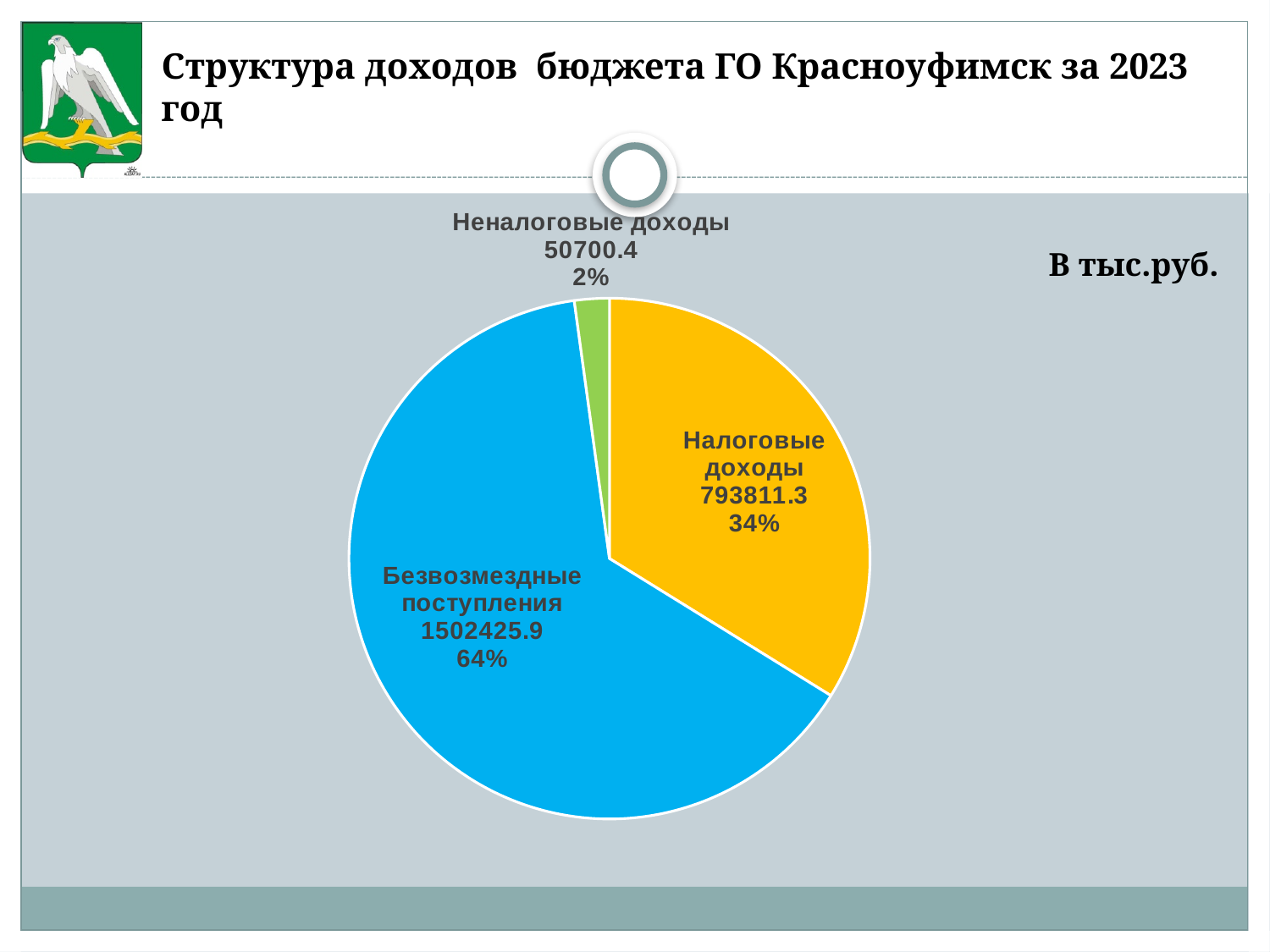
What type of chart is shown on the slide? pie chart Which category has the smallest share of the pie? Неналоговые доходы Which category has the largest share of the pie? Безвозмездные поступления What share of the pie does Налоговые доходы represent? 34% What is the value for Налоговые доходы? 793811.3 What share of the pie does Неналоговые доходы represent? 2% How many slices does the pie chart have? 3 What is the value for Безвозмездные поступления? 1502425.9 In what units are the values on the chart given, according to the slide? тыс.руб. What is the value for Неналоговые доходы? 50700.4 What is the difference between the values for Безвозмездные поступления and Налоговые доходы? 708614.6 Which is larger, the value for Налоговые доходы or the value for Неналоговые доходы? Налоговые доходы